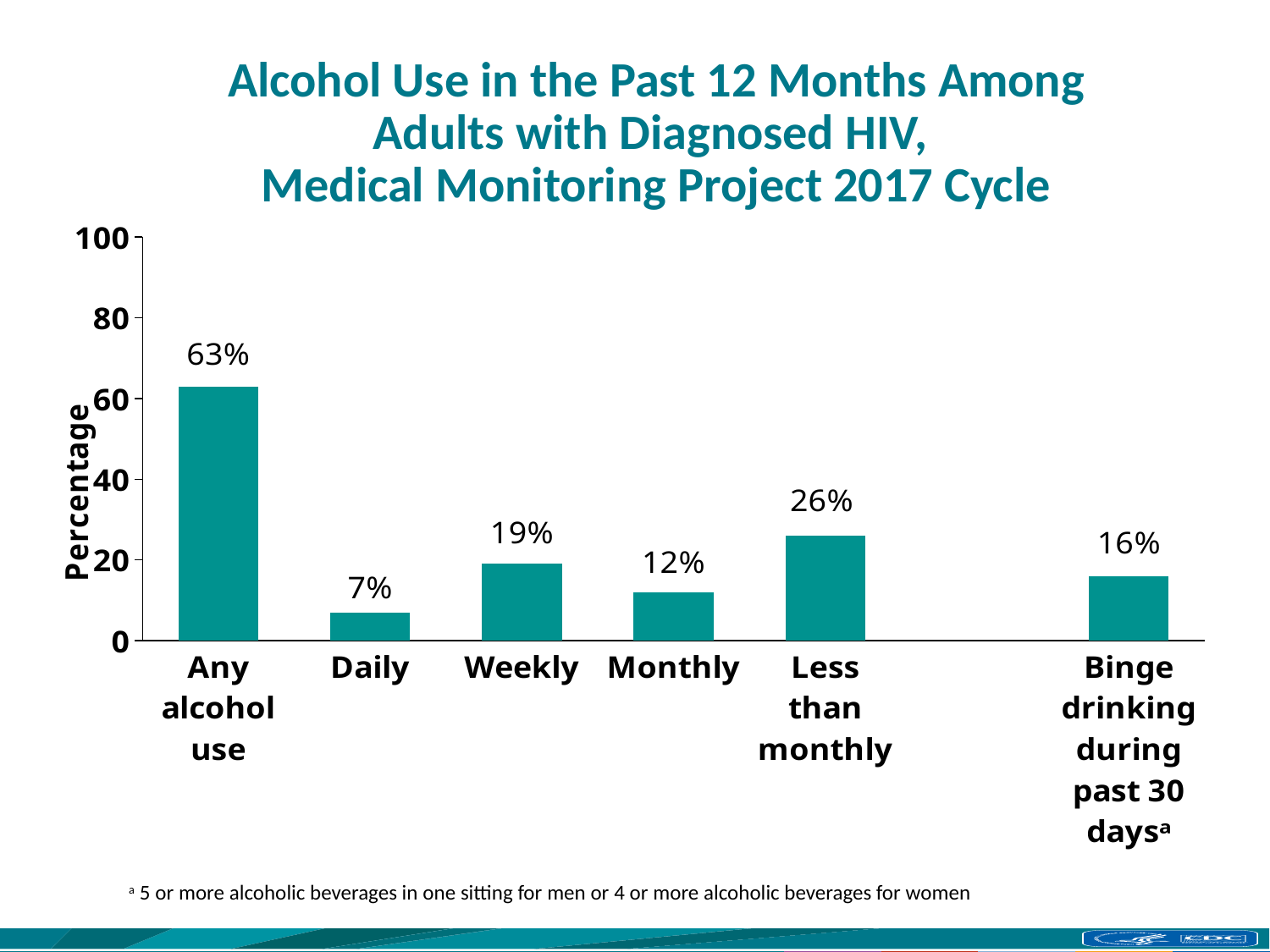
What is the label of the y axis? Percentage Which is larger, the value for Less than monthly or the value for Weekly? Less than monthly What is the difference between the Weekly and Monthly percentages? 7% Is the value for Any alcohol use greater or less than 60? greater What percentage is shown for Any alcohol use? 63% What is the value for Less than monthly? 26% Which category has the lowest percentage? Daily How many categories are shown on the x axis? 6 What percentage is shown for Binge drinking during past 30 days? 16% What is the value for Daily alcohol use? 7% What kind of chart is shown on the slide? Bar chart Which category has the highest percentage? Any alcohol use